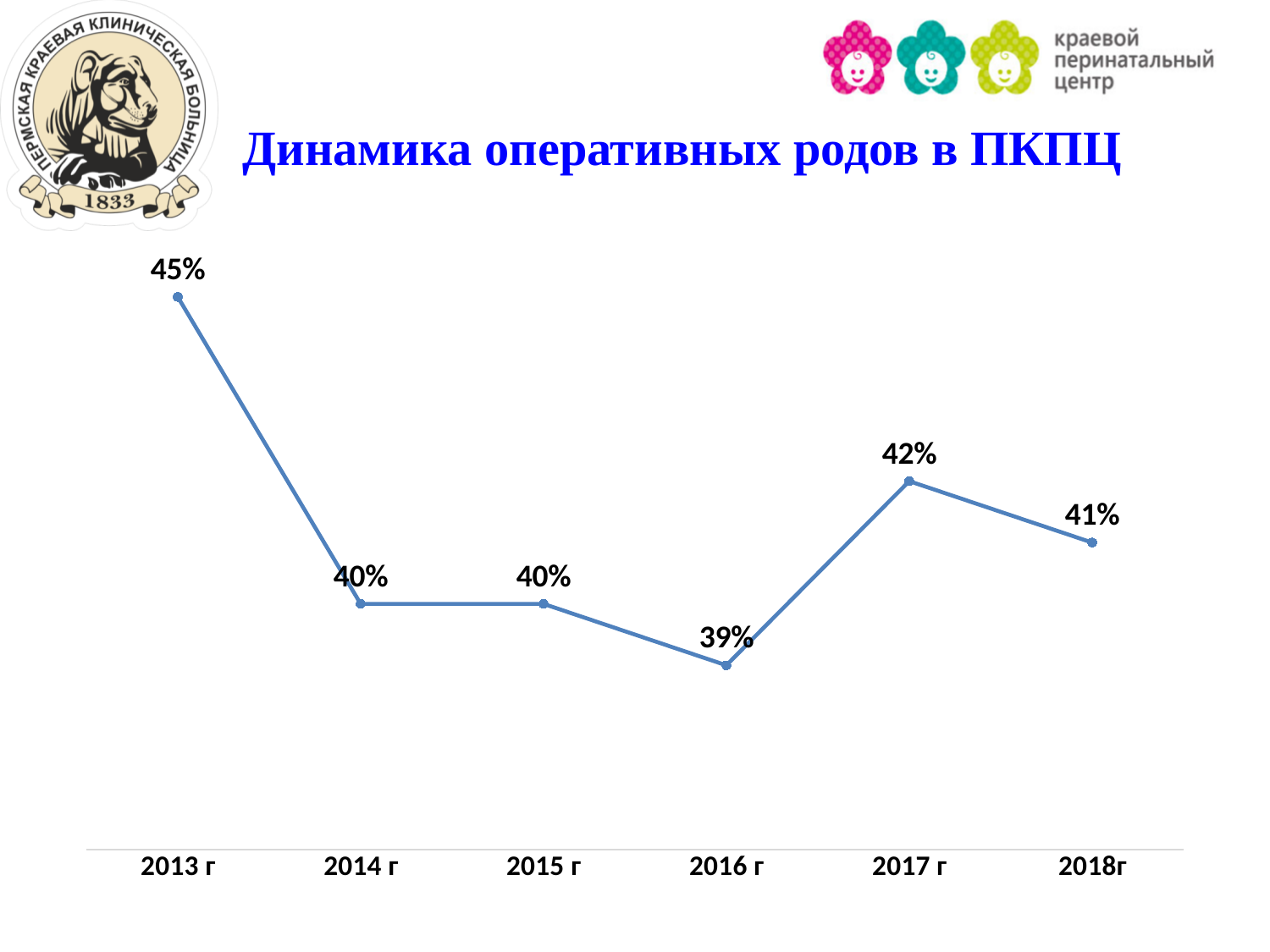
What is the value for 2016 г? 39% How many years are plotted on the chart? 6 Which is larger, the value for 2017 г or the value for 2014 г? 2017 г Which year has the highest value? 2013 г What is the value for 2018г? 41% What is the value for 2013 г? 45% What kind of chart is shown on the slide? line chart What is the difference between the values for 2013 г and 2016 г? 6% What is the title of the chart? Динамика оперативных родов в ПКПЦ Which year has the lowest value? 2016 г What is the difference between the values for 2017 г and 2018г? 1% What is the value for 2017 г? 42%